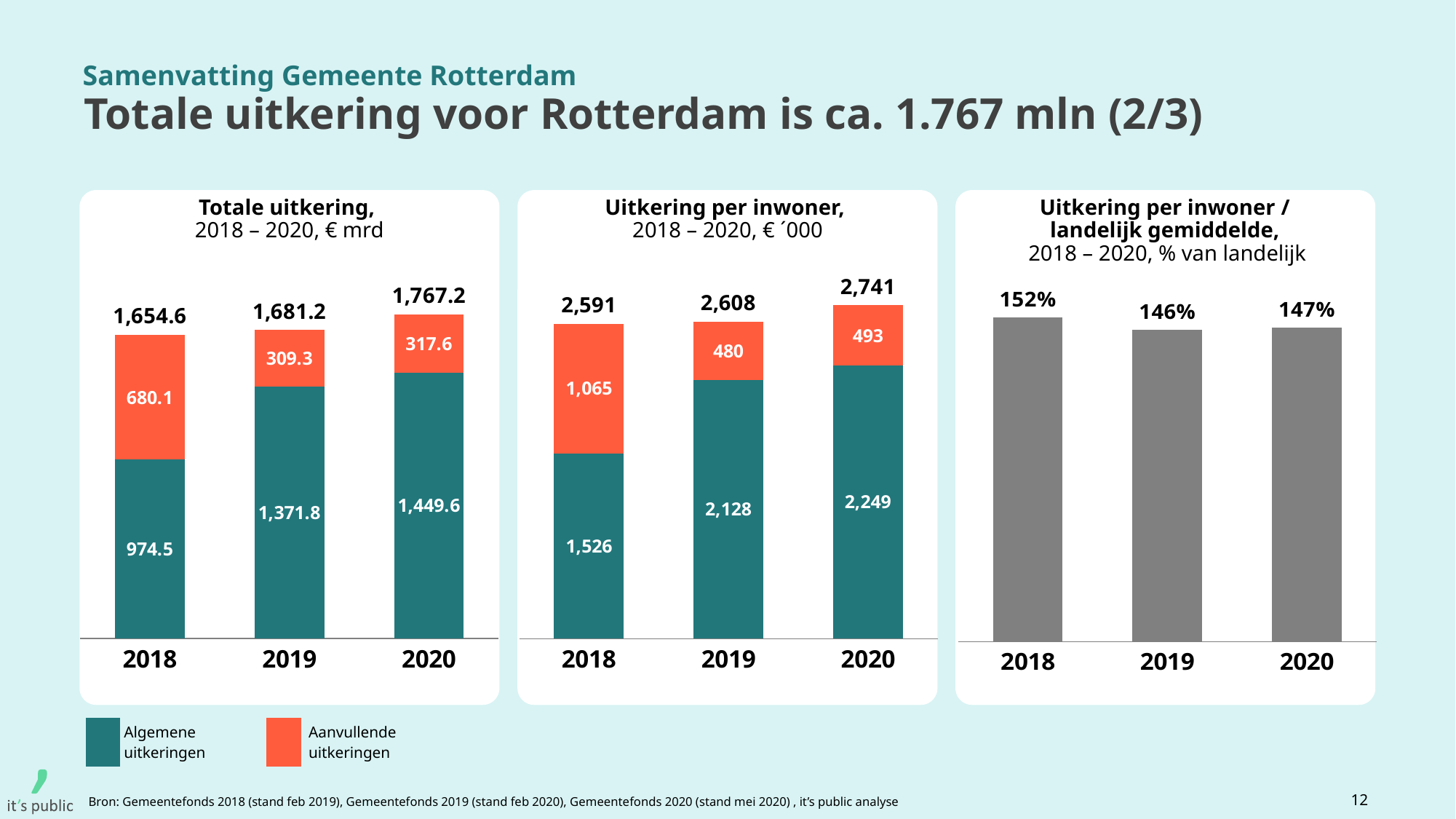
In the 'Uitkering per inwoner' chart, what is the total of the stacked bar for 2018? 2,591 How many series does the legend at the bottom of the slide list? 2 In the 'Totale uitkering' chart, what is the value of Algemene uitkeringen for 2018? 974.5 What kind of chart is the 'Uitkering per inwoner / landelijk gemiddelde' chart? Bar chart In the 'Uitkering per inwoner' chart, what is the difference between the Algemene uitkeringen values for 2020 and 2019? 121 In the 'Uitkering per inwoner / landelijk gemiddelde' chart, what is the difference between the 2018 and 2019 values? 6 percentage points In the 'Uitkering per inwoner' chart, what is the value of Algemene uitkeringen for 2020? 2,249 In the 'Totale uitkering' chart, what is the value of Aanvullende uitkeringen for 2019? 309.3 In the 'Totale uitkering' chart, what is the total of the stacked bar for 2020? 1,767.2 In the 'Uitkering per inwoner / landelijk gemiddelde' chart, which year has the highest value? 2018 In the 'Uitkering per inwoner / landelijk gemiddelde' chart, which year has the lowest value? 2019 In the 'Totale uitkering' chart, which is larger: Aanvullende uitkeringen in 2018 or in 2020? 2018